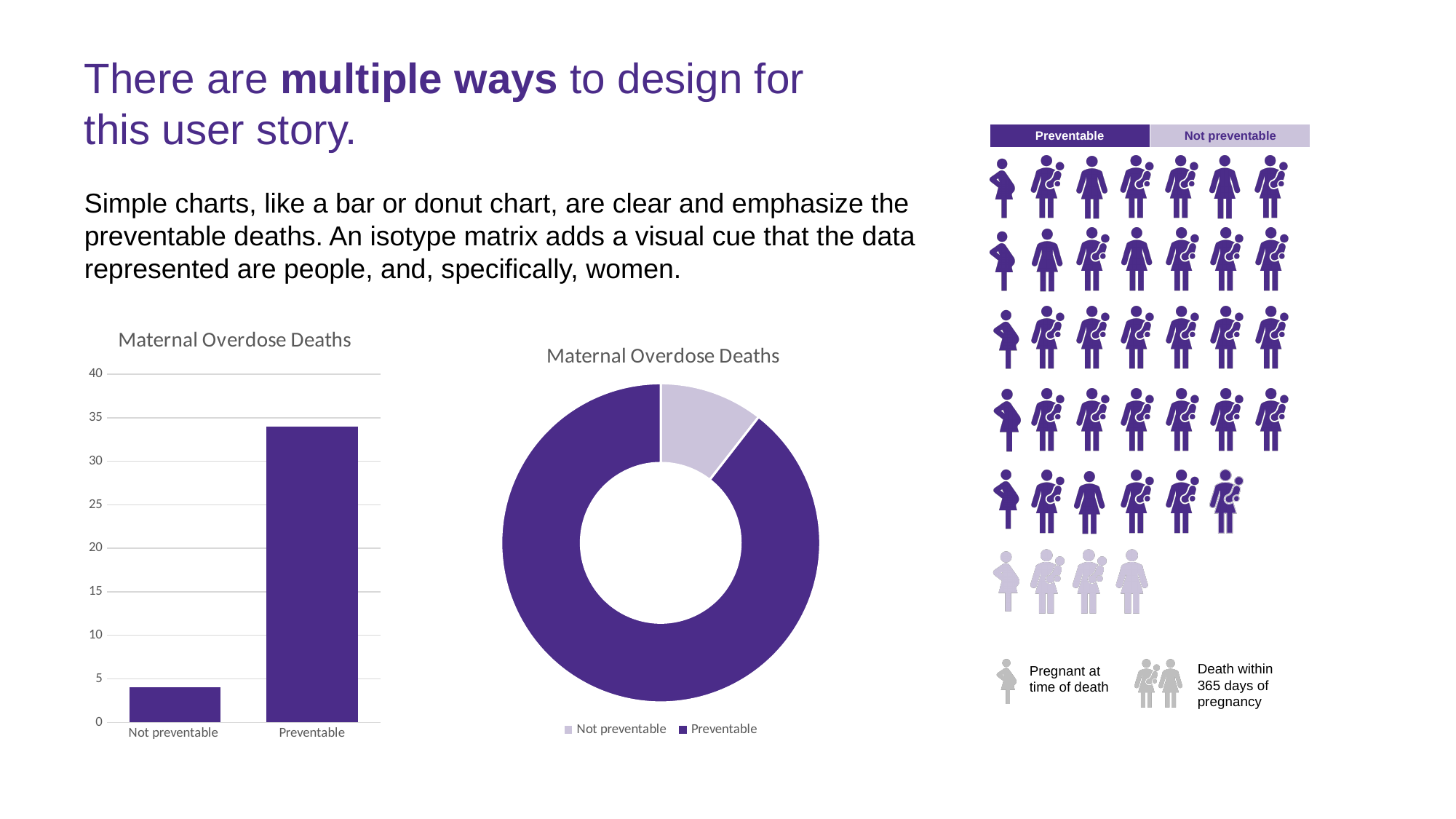
In the bar chart, is the value for Preventable greater or less than 35? less In the isotype matrix on the right, which category is shown in the dark purple colour? Preventable In the bar chart, which category has the highest value? Preventable In the bar chart, is the value for Not preventable greater or less than 5? less How many entries does the legend of the donut chart list? 2 What kind of chart is the left-hand chart titled "Maternal Overdose Deaths"? bar chart How many categories are shown on the x axis of the bar chart? 2 In the donut chart, which slice is larger, Not preventable or Preventable? Preventable In the bar chart, is the value for Preventable greater or less than 30? greater In the bar chart, which category has the lowest value? Not preventable What kind of chart is the middle chart titled "Maternal Overdose Deaths"? donut chart What is the title of the bar chart? Maternal Overdose Deaths